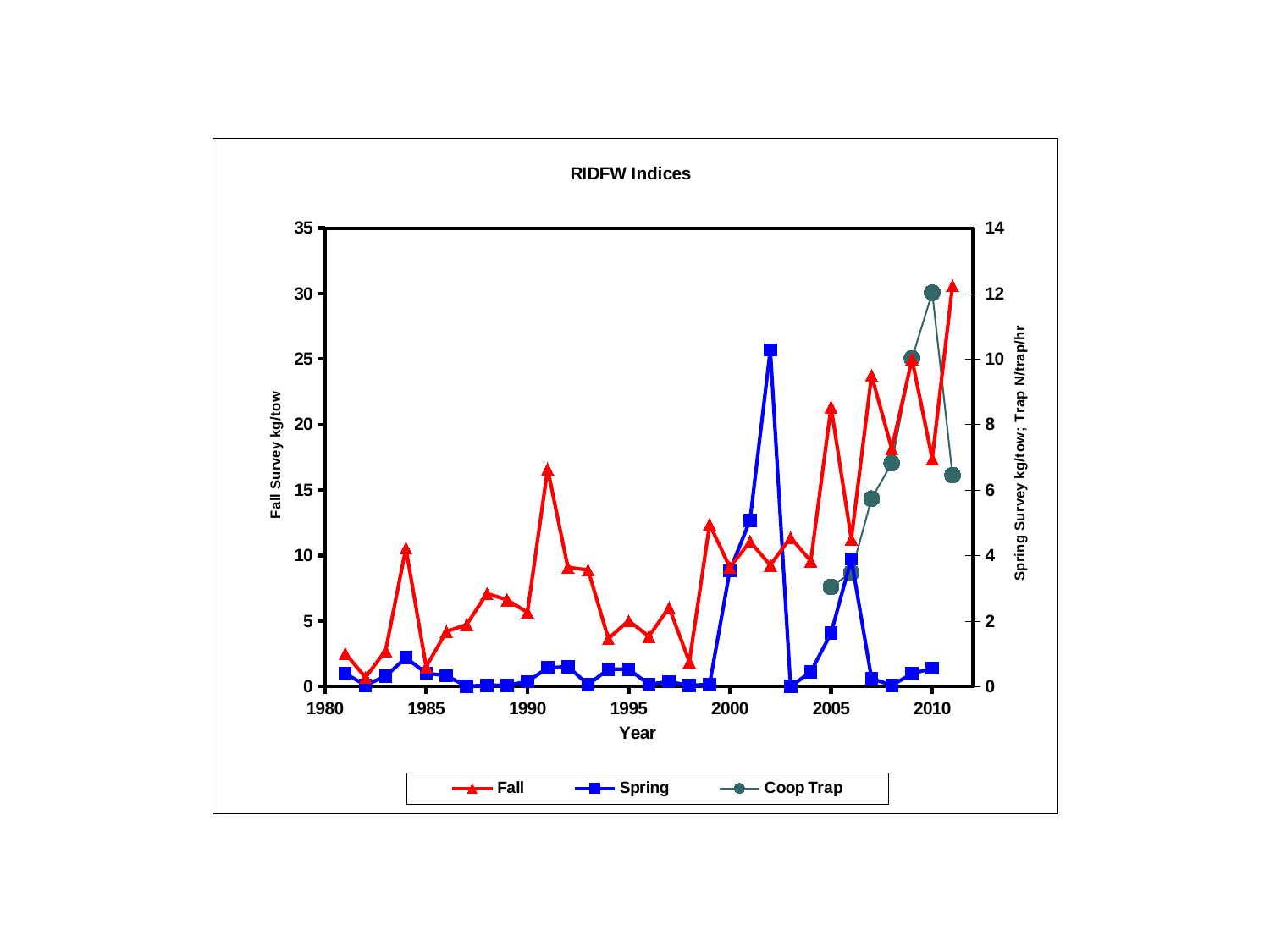
Is the Coop Trap value for 2005 greater or less than 4 on the right axis? less Is the Fall value for 1991 greater or less than 15 on the left axis? greater Does the Coop Trap series generally rise or fall from 2005 to 2010? rise What is the title of the chart? RIDFW Indices How many series does the legend list? 3 What is the label of the left vertical axis? Fall Survey kg/tow In which year does the Fall series reach its highest value? 2011 Is the Fall value for 2005 greater or less than 20 on the left axis? greater In which year does the Spring series reach its highest value? 2002 What kind of chart is shown on the slide? line chart In which year does the Coop Trap series reach its highest value? 2010 Which is larger, the Coop Trap value for 2010 or for 2011? 2010